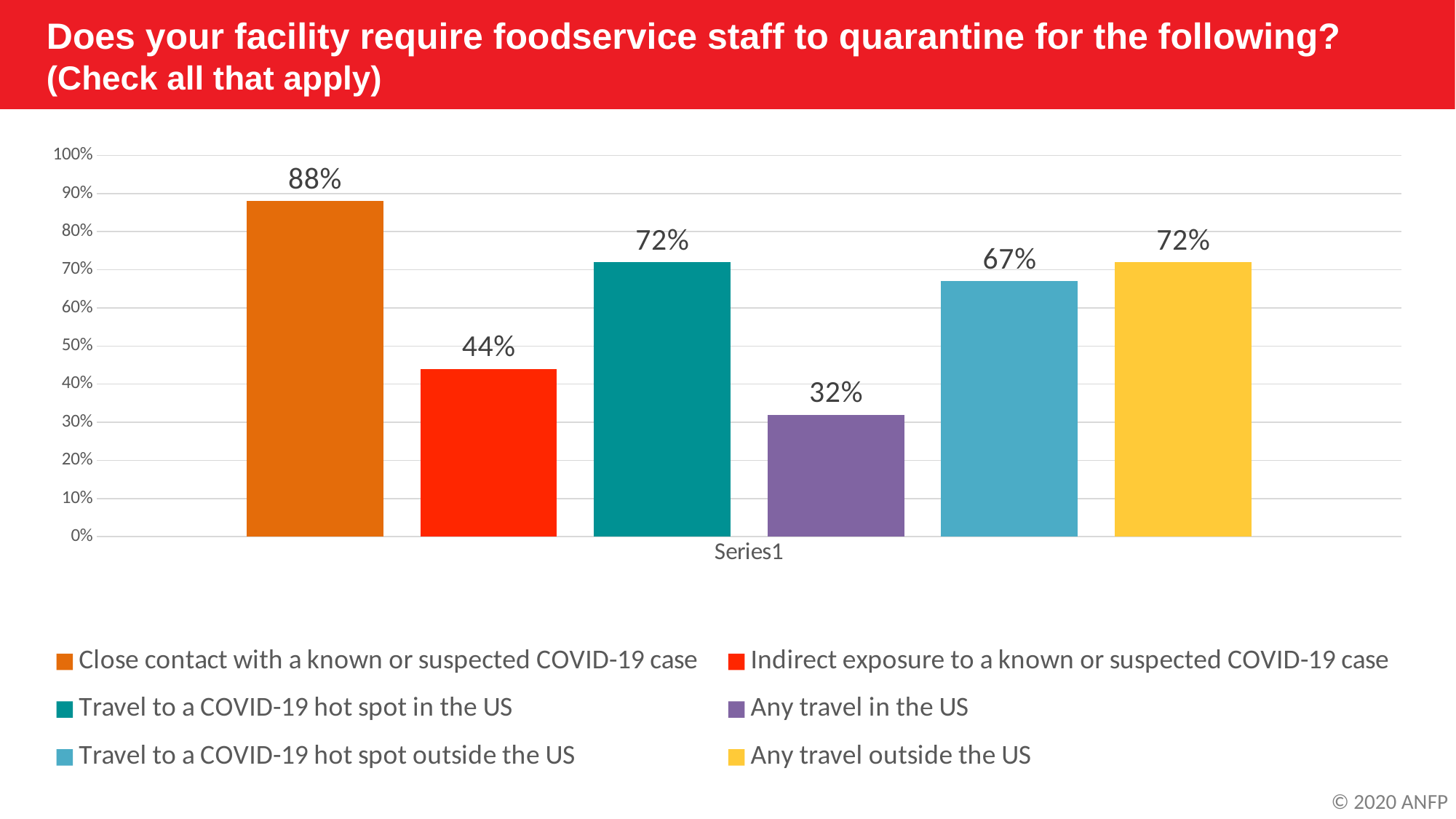
Which category has the highest value? Close contact with a known or suspected COVID-19 case What is the difference between 'Travel to a COVID-19 hot spot in the US' and 'Travel to a COVID-19 hot spot outside the US'? 5% What colour is the bar for 'Any travel outside the US'? Yellow Which is larger: the value for 'Indirect exposure to a known or suspected COVID-19 case' or 'Any travel outside the US'? Any travel outside the US What is the difference between the values for 'Close contact with a known or suspected COVID-19 case' and 'Any travel in the US'? 56% What is the value for 'Travel to a COVID-19 hot spot outside the US'? 67% How many bars are shown in the chart? 6 What is the value for 'Any travel in the US'? 32% What kind of chart is shown on the slide? Bar chart What is the value for 'Indirect exposure to a known or suspected COVID-19 case'? 44% Which category has the lowest value? Any travel in the US What percentage of facilities require foodservice staff to quarantine for close contact with a known or suspected COVID-19 case? 88%